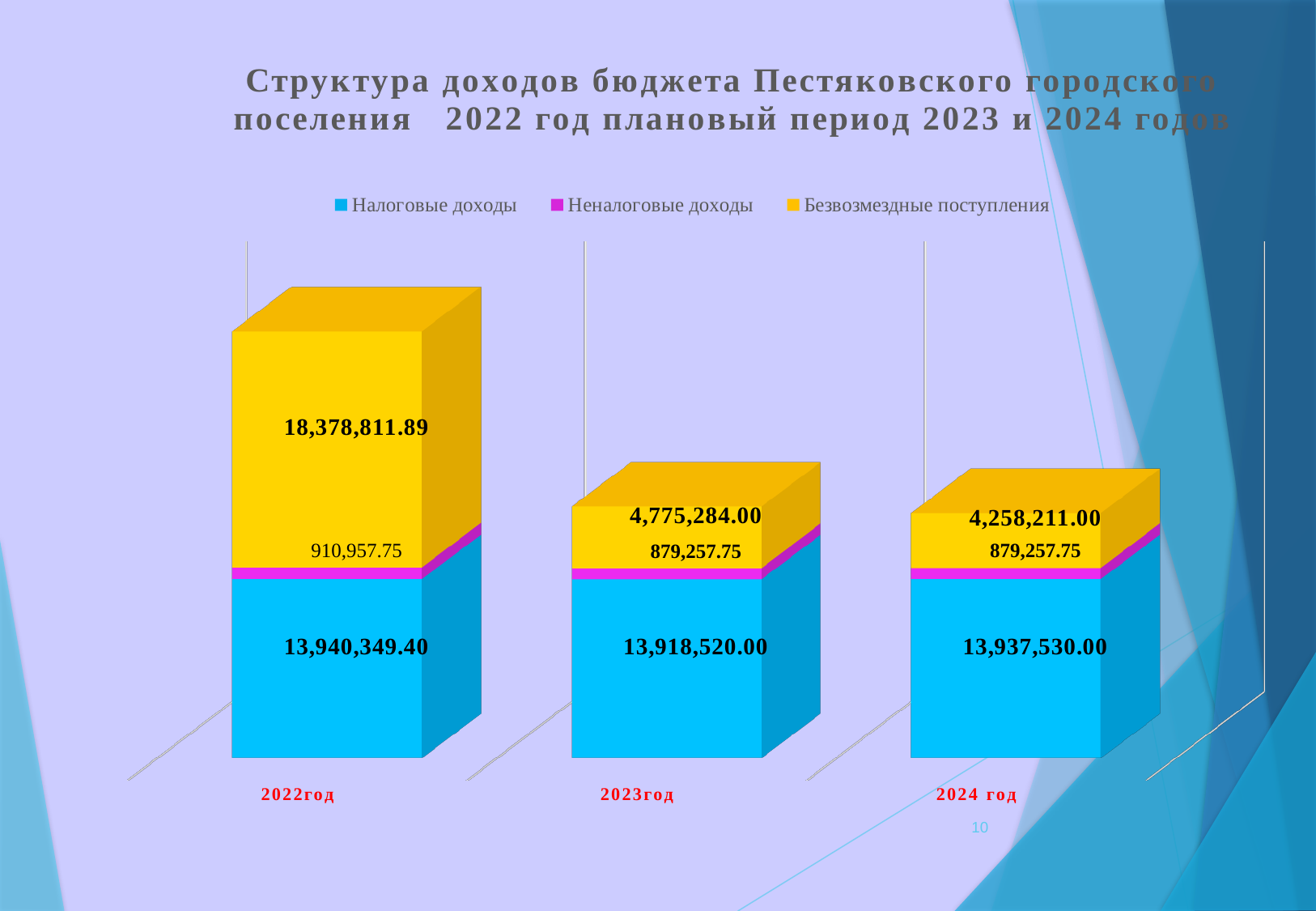
What is the value of Налоговые доходы for 2023год? 13,918,520.00 How many years (categories) are shown on the x axis? 3 In which year is Безвозмездные поступления the highest? 2022год Which colour represents Налоговые доходы in the legend? Blue What type of chart is shown on the slide? Stacked bar chart What is the difference between Безвозмездные поступления in 2023год and 2024 год? 517,073.00 What is the total of the stacked bar for 2023год? 19,573,061.75 What is the value of Безвозмездные поступления for 2024 год? 4,258,211.00 What is the value of Неналоговые доходы for 2024 год? 879,257.75 In which year is Безвозмездные поступления the lowest? 2024 год How many series does the legend list? 3 What is the value of Безвозмездные поступления for 2022год? 18,378,811.89